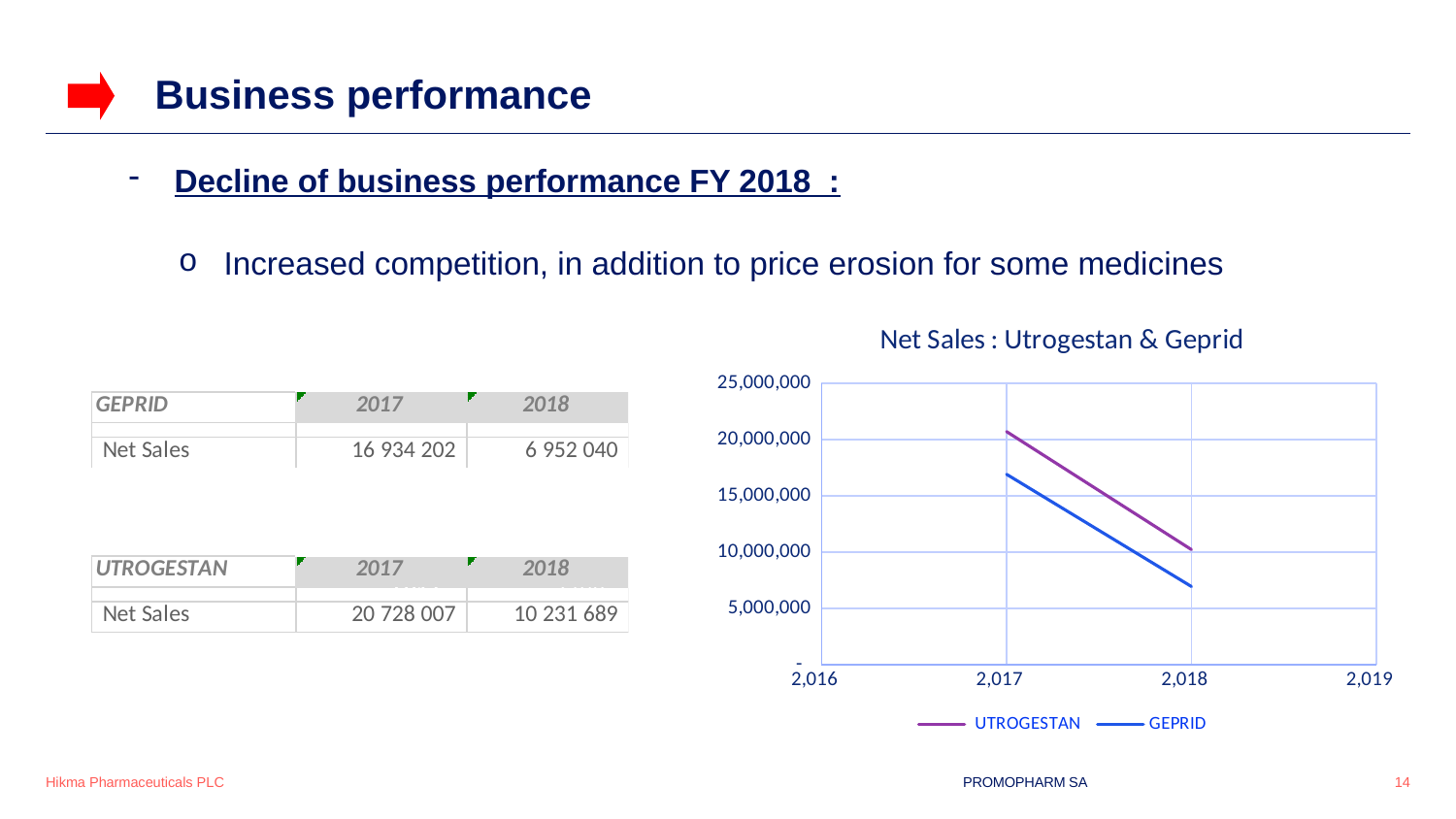
What kind of chart is shown on the slide? line chart Is the value for UTROGESTAN in 2017 greater or less than 20,000,000? greater Is the value for UTROGESTAN in 2018 greater or less than 15,000,000? less Is the value for GEPRID in 2018 greater or less than 10,000,000? less According to the table on the slide, what were the net sales of UTROGESTAN in 2018? 10 231 689 Do the net sales of GEPRID rise or fall from 2017 to 2018 in the chart? fall Which series has the higher net sales in 2017 in the chart, UTROGESTAN or GEPRID? UTROGESTAN Which two series are listed in the chart legend? UTROGESTAN and GEPRID How many series does the legend of the chart list? 2 According to the table on the slide, what were the net sales of GEPRID in 2017? 16 934 202 What is the title of the chart? Net Sales : Utrogestan & Geprid